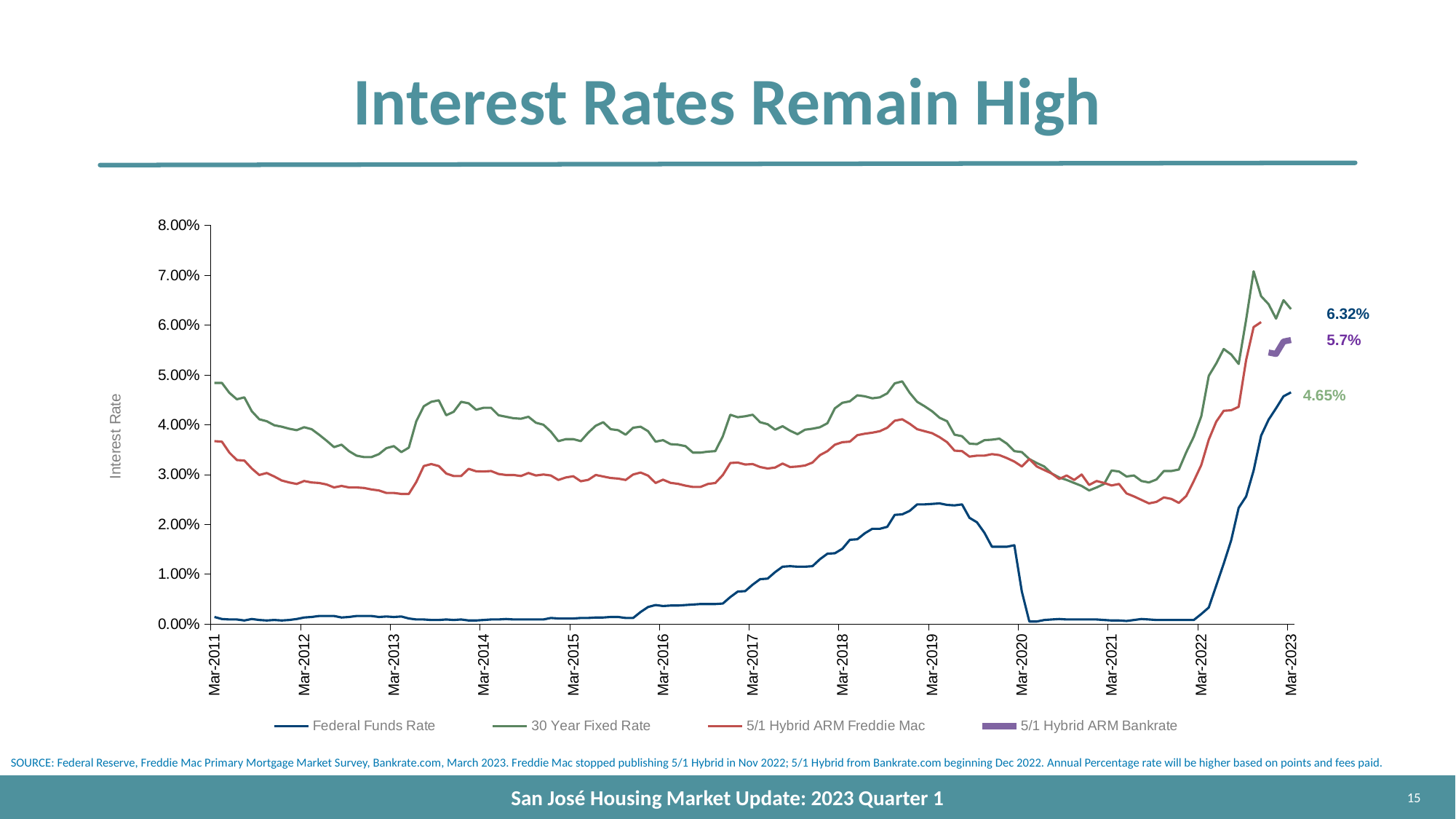
What is the labelled value for the 5/1 Hybrid ARM Bankrate series at the right end of the chart? 5.7% Is the Federal Funds Rate at Mar-2016 greater or less than 1.00%? less What is the lowest value label printed on the chart? 4.65% What is the title of the chart on the slide? Interest Rates Remain High What is the highest value label printed on the chart? 6.32% Which series reaches the highest peak on the chart? 30 Year Fixed Rate Does the Federal Funds Rate rise or fall between Mar-2022 and Mar-2023? rise What kind of chart is shown on the slide? line chart Is the 30 Year Fixed Rate at Mar-2011 greater or less than 4.00%? greater At Mar-2015, which is higher: the 30 Year Fixed Rate or the 5/1 Hybrid ARM Freddie Mac rate? 30 Year Fixed Rate How many series does the legend list? 4 Is the Federal Funds Rate at Mar-2019 greater or less than 2.00%? greater